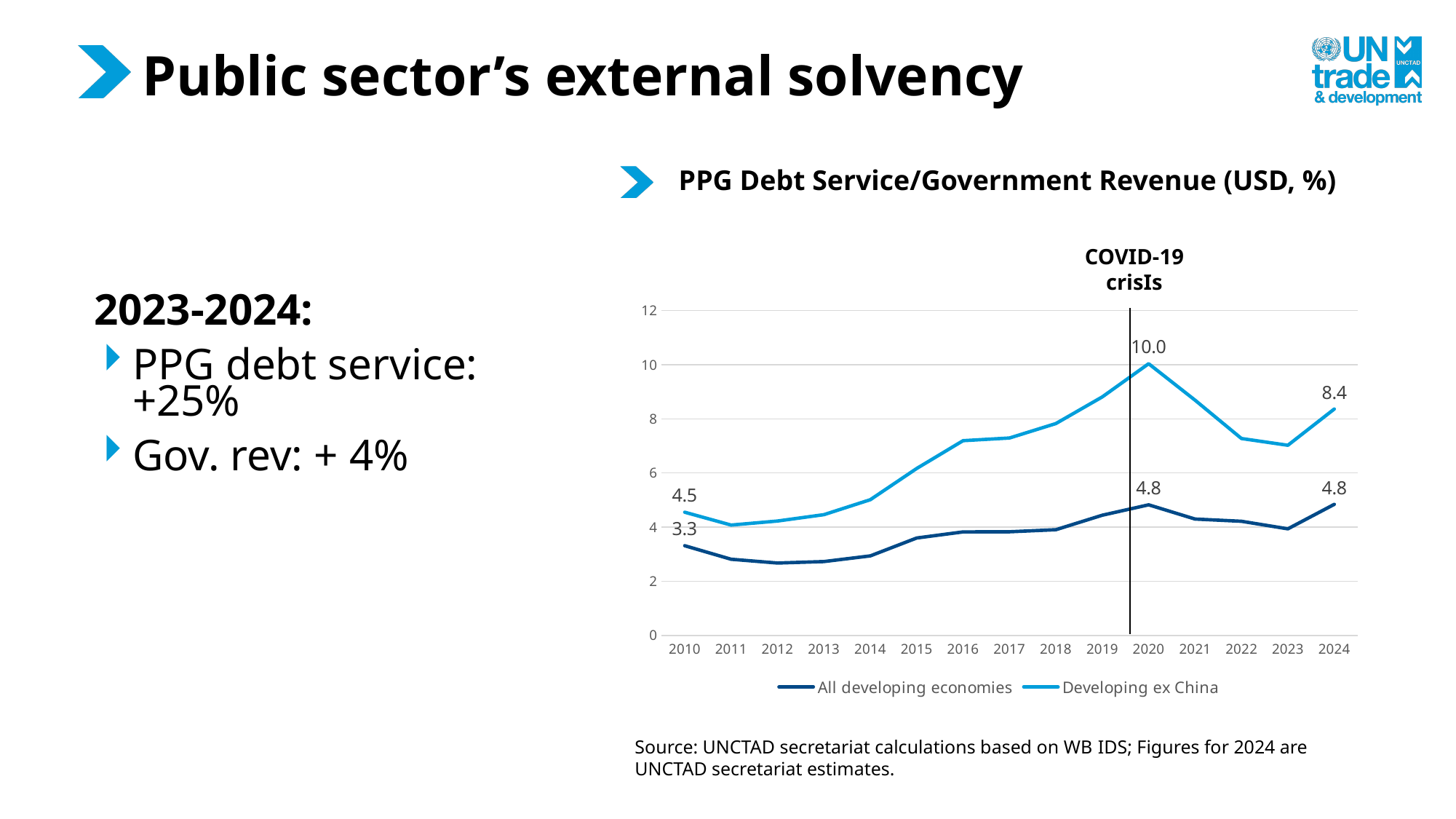
Which series has the higher value in 2020, All developing economies or Developing ex China? Developing ex China What is the value for Developing ex China in 2024? 8.4 Is the value for Developing ex China in 2016 greater or less than 6? greater What is the value for All developing economies in 2010? 3.3 What is the value for All developing economies in 2024? 4.8 How many years are shown on the x axis? 15 How many series does the legend list? 2 What is the difference between the Developing ex China and All developing economies values in 2010? 1.2 In which year does the Developing ex China series reach its highest value? 2020 What is the difference between the Developing ex China value in 2020 and in 2024? 1.6 What is the value for Developing ex China in 2020? 10.0 What type of chart is shown on the slide? line chart